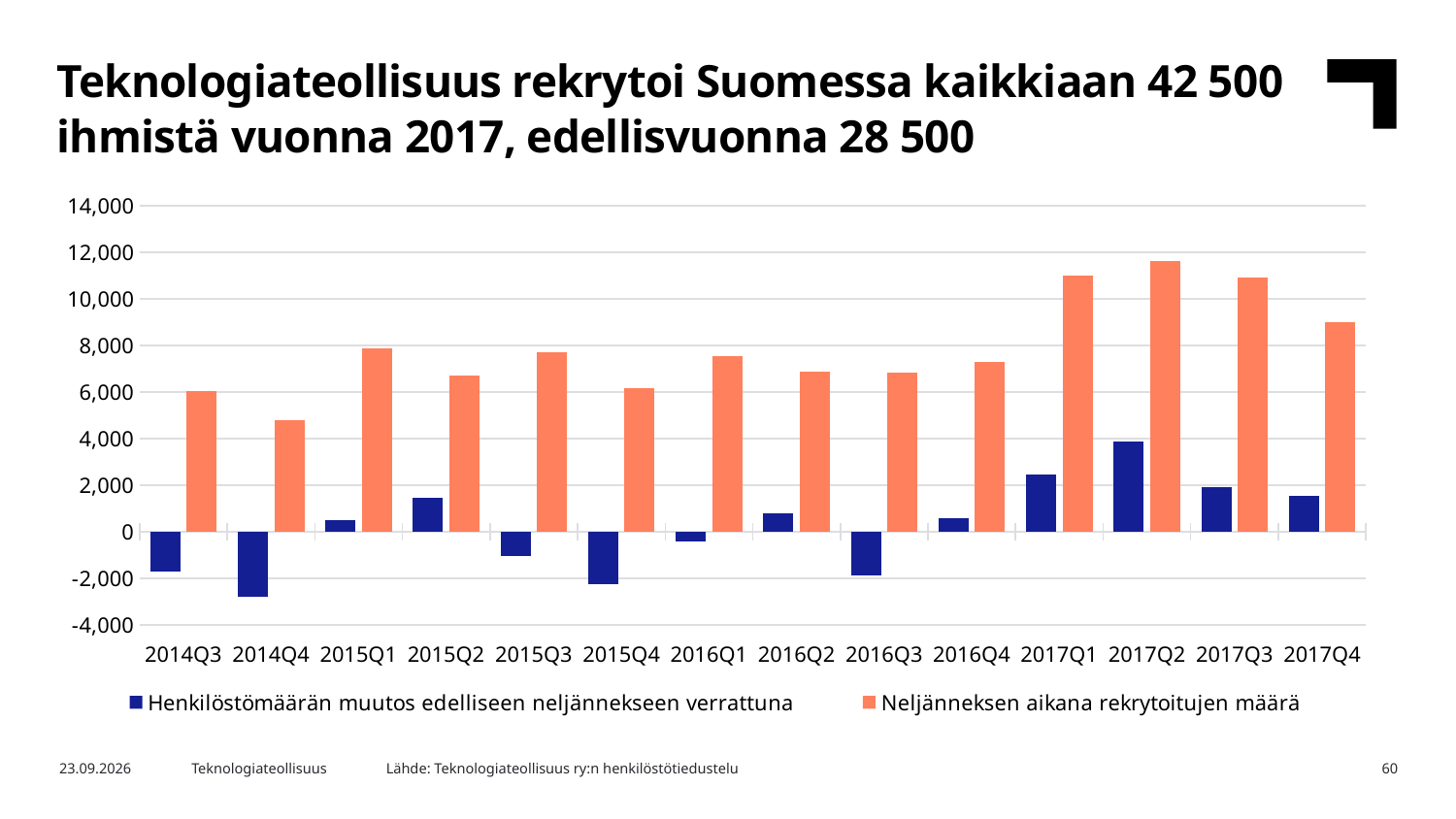
Which colour represents 'Neljänneksen aikana rekrytoitujen määrä' in the chart? orange In which quarter is the value for 'Neljänneksen aikana rekrytoitujen määrä' highest? 2017Q2 Is the value for 'Henkilöstömäärän muutos edelliseen neljännekseen verrattuna' in 2014Q4 greater or less than -2,000? less In which quarter is the value for 'Neljänneksen aikana rekrytoitujen määrä' lowest? 2014Q4 How many quarters are shown on the x axis of the chart? 14 In which quarter is the value for 'Henkilöstömäärän muutos edelliseen neljännekseen verrattuna' lowest? 2014Q4 Is the value for 'Neljänneksen aikana rekrytoitujen määrä' in 2014Q4 greater or less than 6,000? less What kind of chart is shown on the slide? bar chart How many series does the chart legend list? 2 Which quarter has the larger value for 'Neljänneksen aikana rekrytoitujen määrä', 2016Q1 or 2017Q1? 2017Q1 In which quarter is the value for 'Henkilöstömäärän muutos edelliseen neljännekseen verrattuna' highest? 2017Q2 Is the value for 'Neljänneksen aikana rekrytoitujen määrä' in 2017Q1 greater or less than 10,000? greater